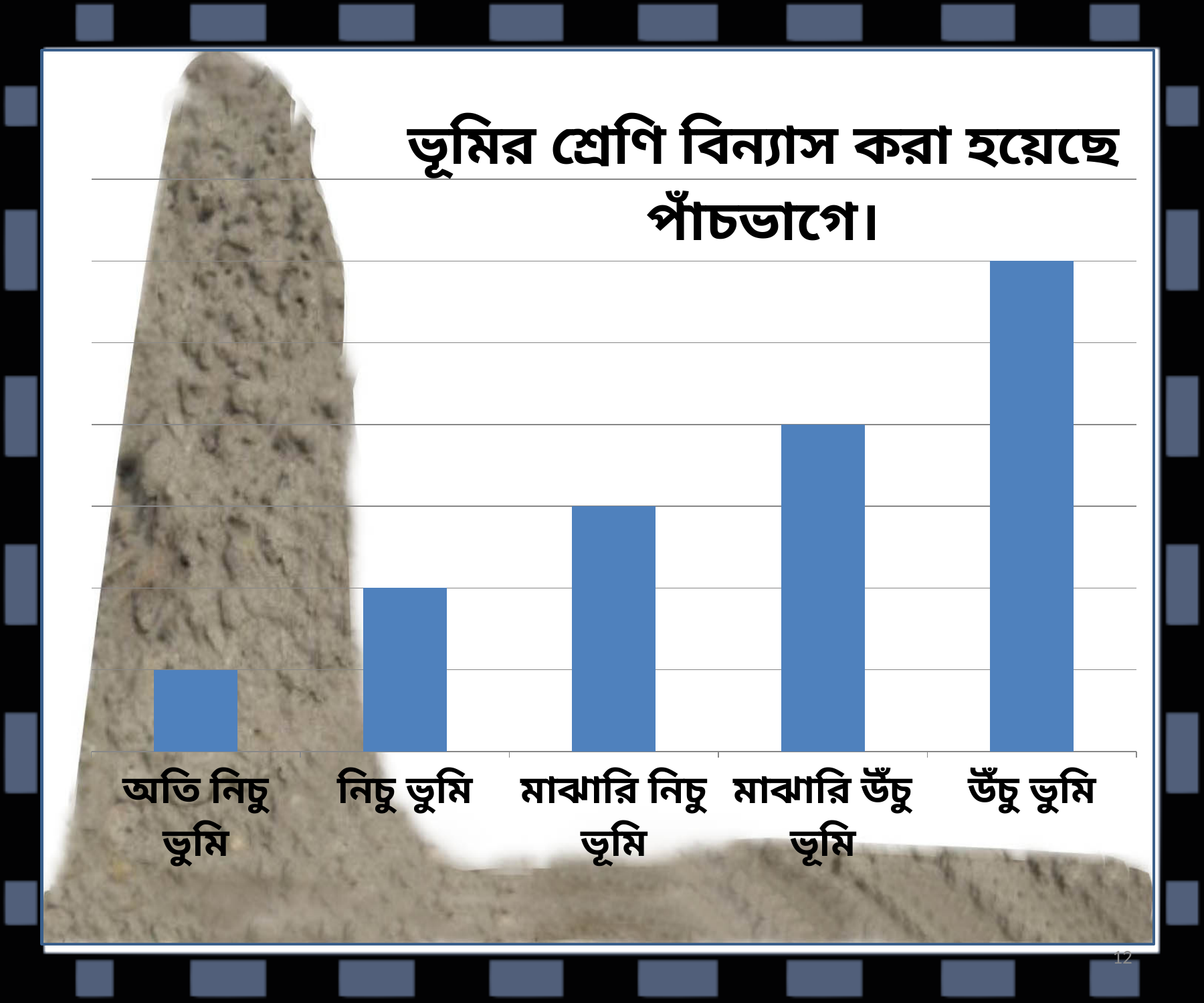
How many categories are shown on the x axis of the chart? 5 Do the bar heights rise or fall from left to right along the x axis? rise What is the title of the chart? ভূমির শ্রেণি বিন্যাস করা হয়েছে পাঁচভাগে। Which category is second from the left on the x axis? নিচু ভুমি Which category has the tallest bar in the chart? উঁচু ভুমি What kind of chart is shown on the slide? bar chart Which category has the shortest bar in the chart? অতি নিচু ভুমি Which bar is taller, নিচু ভুমি or মাঝারি উঁচু ভূমি? মাঝারি উঁচু ভূমি What colour are the bars in the chart? blue Which bar is shorter, উঁচু ভুমি or নিচু ভুমি? নিচু ভুমি Which bar is taller, অতি নিচু ভুমি or মাঝারি নিচু ভূমি? মাঝারি নিচু ভূমি